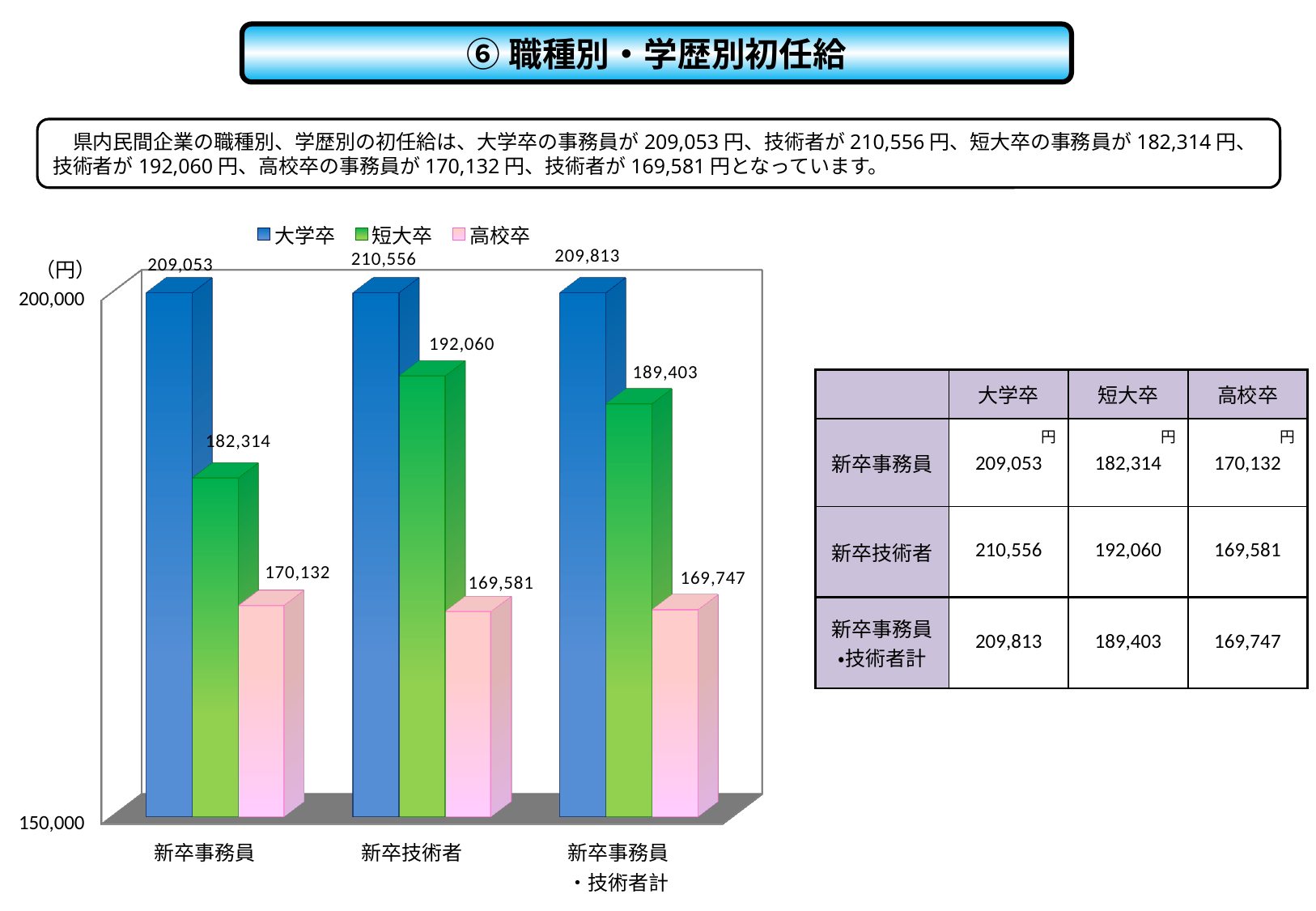
What is the value for 高校卒 in the 新卒事務員・技術者計 category? 169,747 What is the difference between the 大学卒 and 短大卒 values for 新卒事務員? 26,739 Which category has the highest 大学卒 value? 新卒技術者 How many categories are shown on the x axis? 3 Which is larger: the 短大卒 value for 新卒事務員 or the 短大卒 value for 新卒技術者? 新卒技術者 What unit is shown on the vertical axis? 円 What kind of chart is shown? bar chart What is the value for 短大卒 in the 新卒技術者 category? 192,060 Which series has the lowest value in the 新卒技術者 category? 高校卒 How many series does the legend list? 3 What is the value for 大学卒 in the 新卒事務員 category? 209,053 Is the 大学卒 value for 新卒事務員・技術者計 greater or less than 200,000? greater